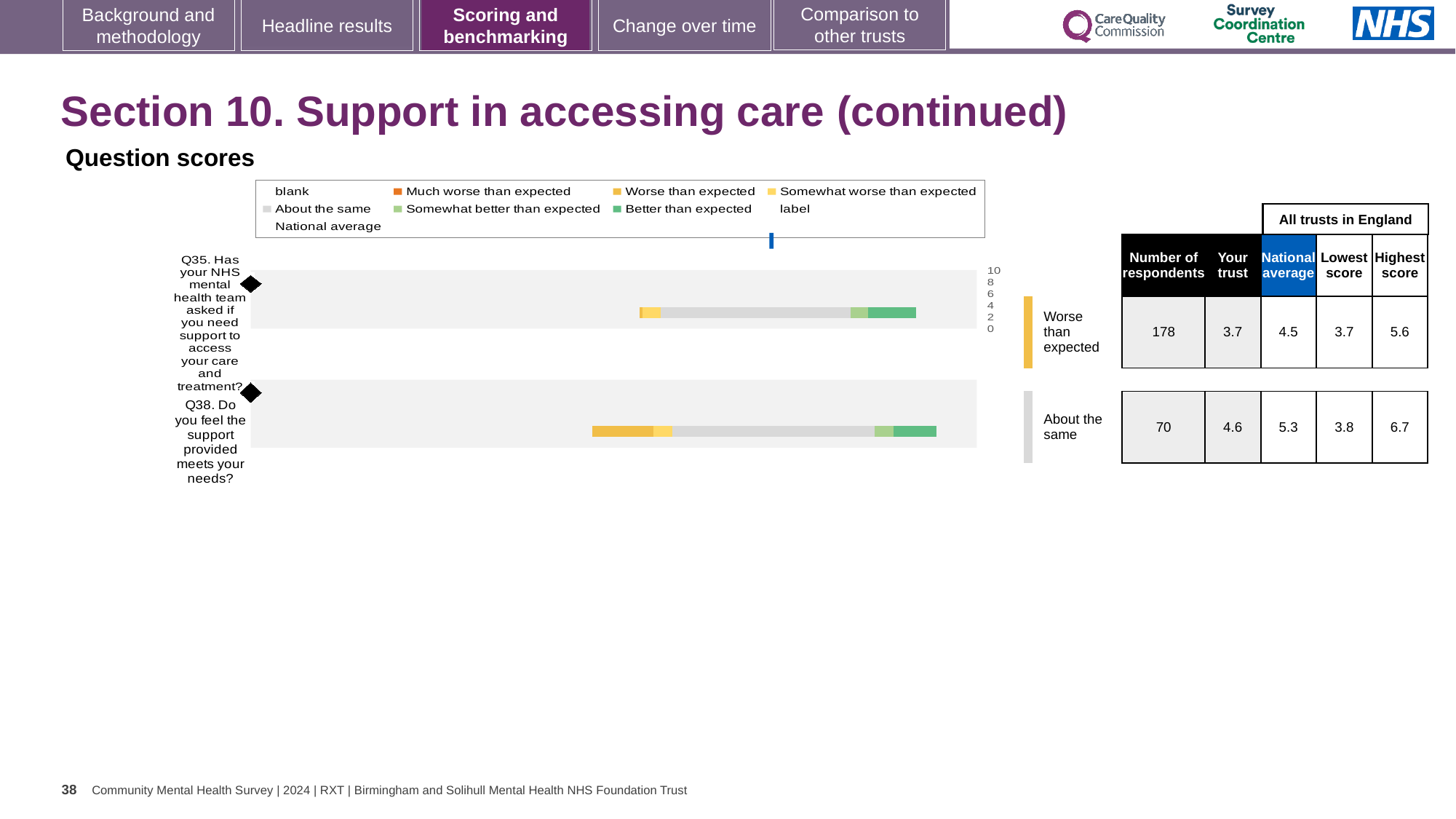
What is the lowest score across all trusts in England for Q38? 3.8 According to the table next to the chart, what is the 'Your trust' score for Q35? 3.7 Which question has the higher 'Your trust' score, Q35 or Q38? Q38 What is the difference between the national average for Q38 and the national average for Q35? 0.8 In the question scores chart, which colour in the legend represents 'Much worse than expected'? orange What is the difference between the highest score and the lowest score for Q38? 2.9 What is the highest score across all trusts in England for Q35? 5.6 How many questions are plotted in the question scores chart? 2 How is the trust's result for Q35 categorised in the chart? Worse than expected According to the table next to the chart, how many respondents answered Q38? 70 What kind of chart is used to show the question scores on this slide? bar chart Which question has the higher national average, Q35 or Q38? Q38